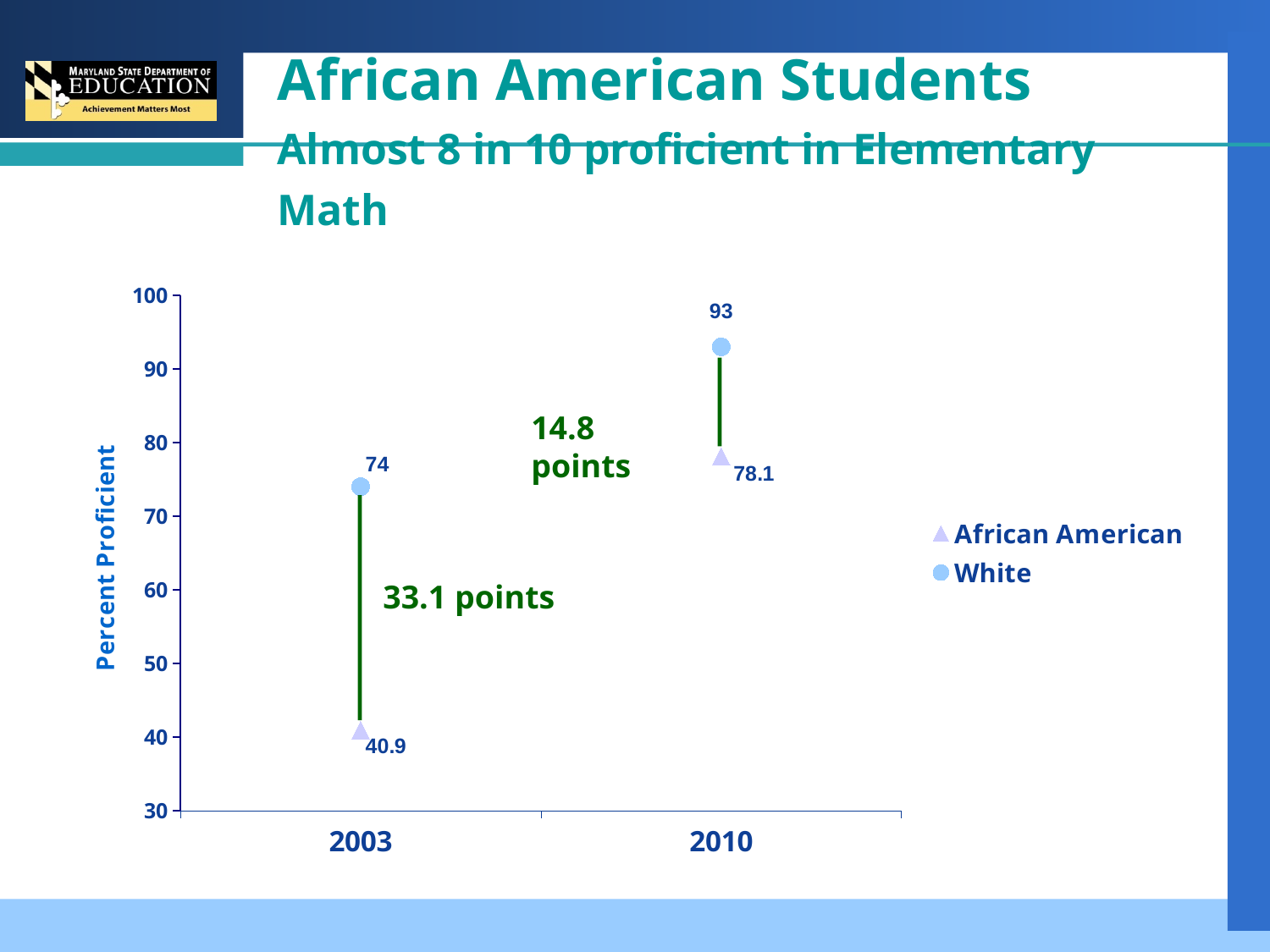
How many series does the legend list? 2 What was the percent proficient for White students in 2010? 93 Which marker shape represents African American students in the legend? Triangle Which group had the higher percent proficient in 2010? White How many years are shown on the x axis? 2 What was the percent proficient for African American students in 2010? 78.1 What is the gap in points between White and African American students in 2010, as labeled on the chart? 14.8 points Did the percent proficient for African American students rise or fall from 2003 to 2010? Rise What is the label of the y axis? Percent Proficient What is the gap in points between White and African American students in 2003, as labeled on the chart? 33.1 points What was the percent proficient for White students in 2003? 74 What was the percent proficient for African American students in 2003? 40.9